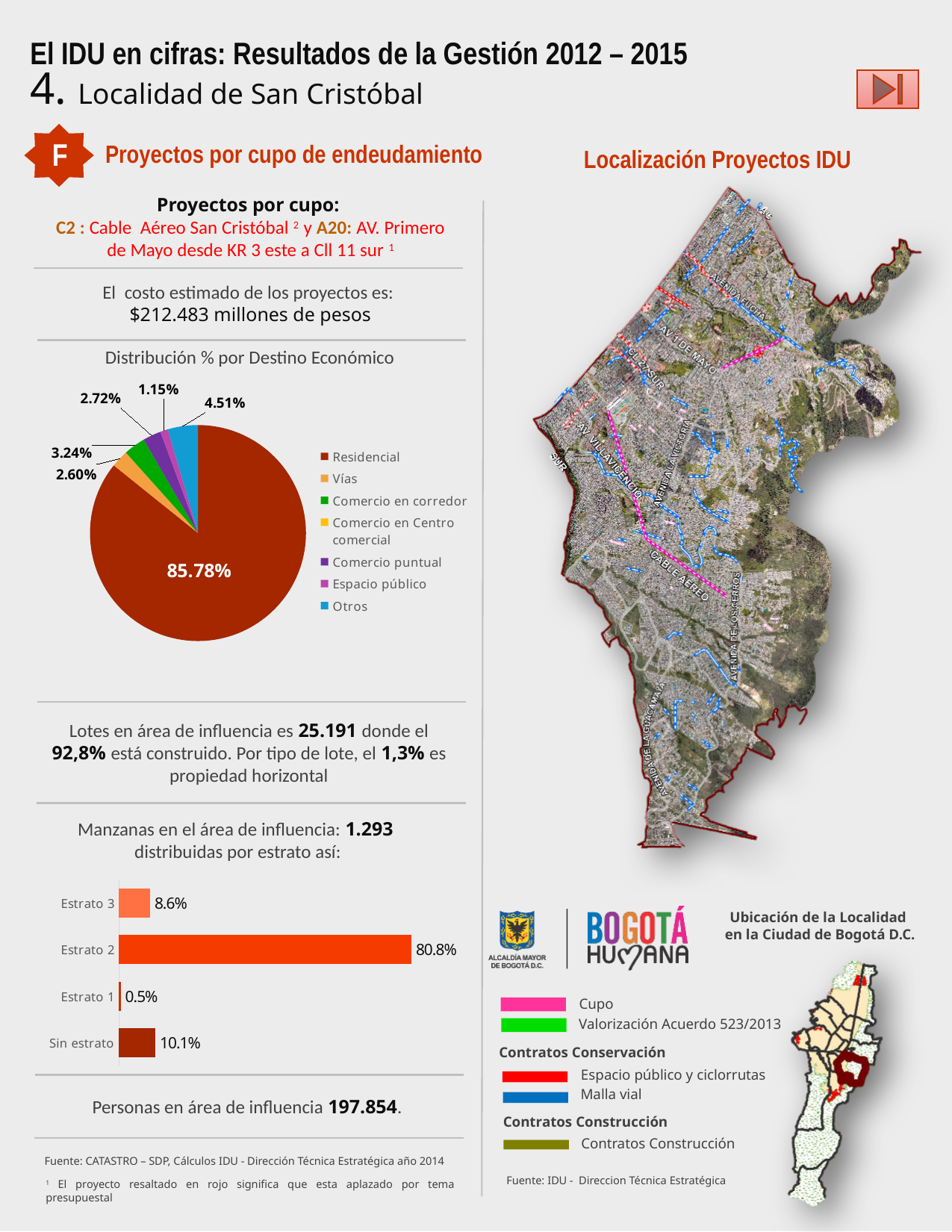
What kind of chart is used for the manzanas by estrato data? Bar chart In the pie chart 'Distribución % por Destino Económico', what is the share for Residencial? 85.78% How many categories does the bar chart of manzanas by estrato show? 4 In the bar chart of manzanas by estrato, which category has the highest value? Estrato 2 In the pie chart 'Distribución % por Destino Económico', which category has the largest slice? Residencial How many entries does the legend of the pie chart 'Distribución % por Destino Económico' list? 7 In the bar chart of manzanas by estrato, what is the difference between Sin estrato and Estrato 3? 1.5 percentage points In the bar chart of manzanas by estrato, which is larger: Estrato 3 or Sin estrato? Sin estrato In the bar chart of manzanas by estrato, which category has the lowest value? Estrato 1 In the bar chart of manzanas by estrato, what is the value for Sin estrato? 10.1% In the bar chart of manzanas by estrato, what is the value for Estrato 2? 80.8% In the bar chart of manzanas by estrato, what is the value for Estrato 1? 0.5%